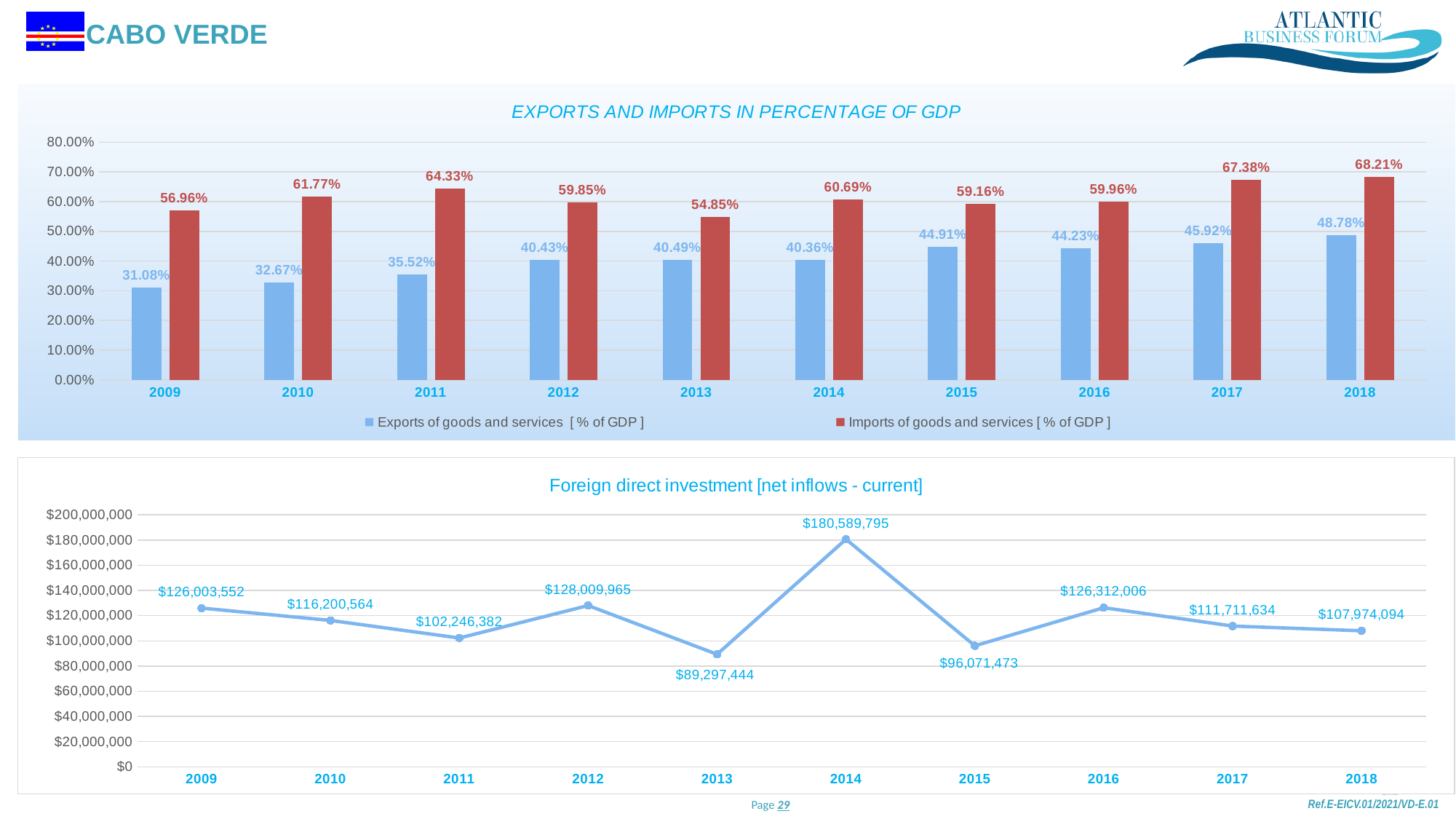
In the 'Exports and Imports in Percentage of GDP' chart, which year had the highest imports as a percentage of GDP? 2018 In the 'Exports and Imports in Percentage of GDP' chart, what is the difference between imports and exports in 2018? 19.43% In the 'Foreign direct investment [net inflows - current]' chart, how many years are plotted? 10 In the 'Exports and Imports in Percentage of GDP' chart, what was the value of imports of goods and services in 2013? 54.85% In the 'Exports and Imports in Percentage of GDP' chart, what was the value of exports of goods and services in 2012? 40.43% In the 'Foreign direct investment [net inflows - current]' chart, what was the value for 2016? $126,312,006 What type of chart is the 'Foreign direct investment [net inflows - current]' chart? Line chart In the 'Exports and Imports in Percentage of GDP' chart, which year had the lowest exports as a percentage of GDP? 2009 What type of chart is the 'Exports and Imports in Percentage of GDP' chart? Bar chart In the 'Foreign direct investment [net inflows - current]' chart, what is the difference between the 2014 and 2013 values? $91,292,351 In the 'Foreign direct investment [net inflows - current]' chart, which year had the lowest value? 2013 In the 'Exports and Imports in Percentage of GDP' chart, how many series does the legend list? 2